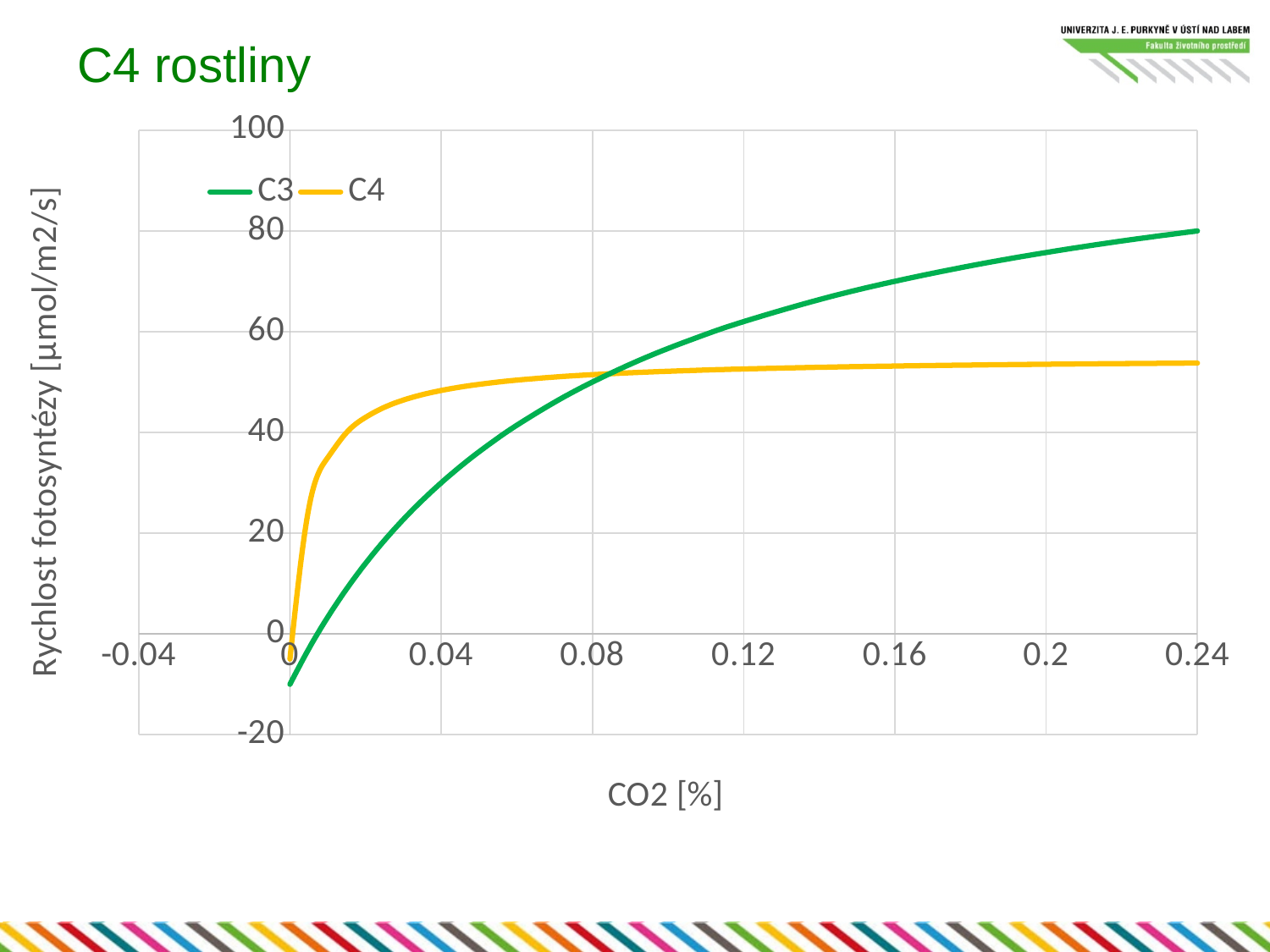
What is the label of the x axis? CO2 [%] Is the value of the C3 line at CO2 = 0.04 greater or less than 40? less At CO2 = 0.2, which line is higher, C3 or C4? C3 How many series does the legend list? 2 Is the value of the C4 line at CO2 = 0.24 greater or less than 60? less At CO2 = 0.04, which line is higher, C3 or C4? C4 Is the value of the C3 line at CO2 = 0 greater or less than 0? less Does the C3 line rise or fall as CO2 increases along the x axis? rise What kind of chart is shown on the slide? line chart What are the two series named in the legend? C3 and C4